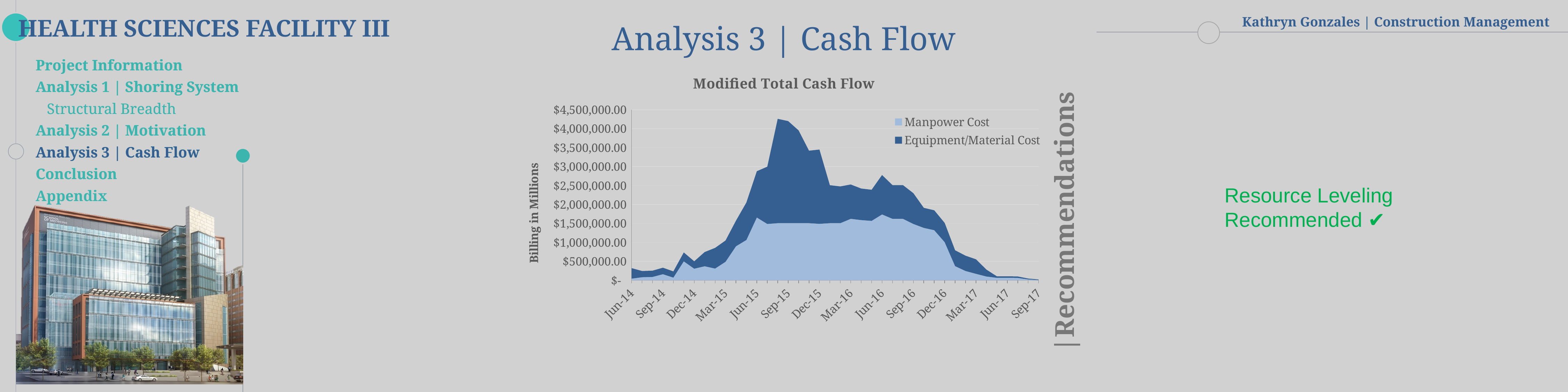
Is the peak stacked total in the "Modified Total Cash Flow" chart greater or less than $4,000,000.00? greater What are the two series named in the legend of the "Modified Total Cash Flow" chart? Manpower Cost and Equipment/Material Cost What is the label on the vertical axis of the "Modified Total Cash Flow" chart? Billing in Millions What kind of chart is shown under the title "Modified Total Cash Flow"? Stacked area chart In the "Modified Total Cash Flow" chart, is the stacked total larger at Sep-15 or at Sep-16? Sep-15 In the "Modified Total Cash Flow" chart, do the stacked totals rise or fall from Sep-15 to Sep-17? fall Is the stacked total at Jun-14 in the "Modified Total Cash Flow" chart greater or less than $500,000.00? less How many date labels are shown along the x axis of the "Modified Total Cash Flow" chart? 14 Is the stacked total at Sep-17 in the "Modified Total Cash Flow" chart greater or less than $500,000.00? less How many series does the legend of the "Modified Total Cash Flow" chart list? 2 Around which x-axis label does the stacked total in the "Modified Total Cash Flow" chart reach its highest point? Sep-15